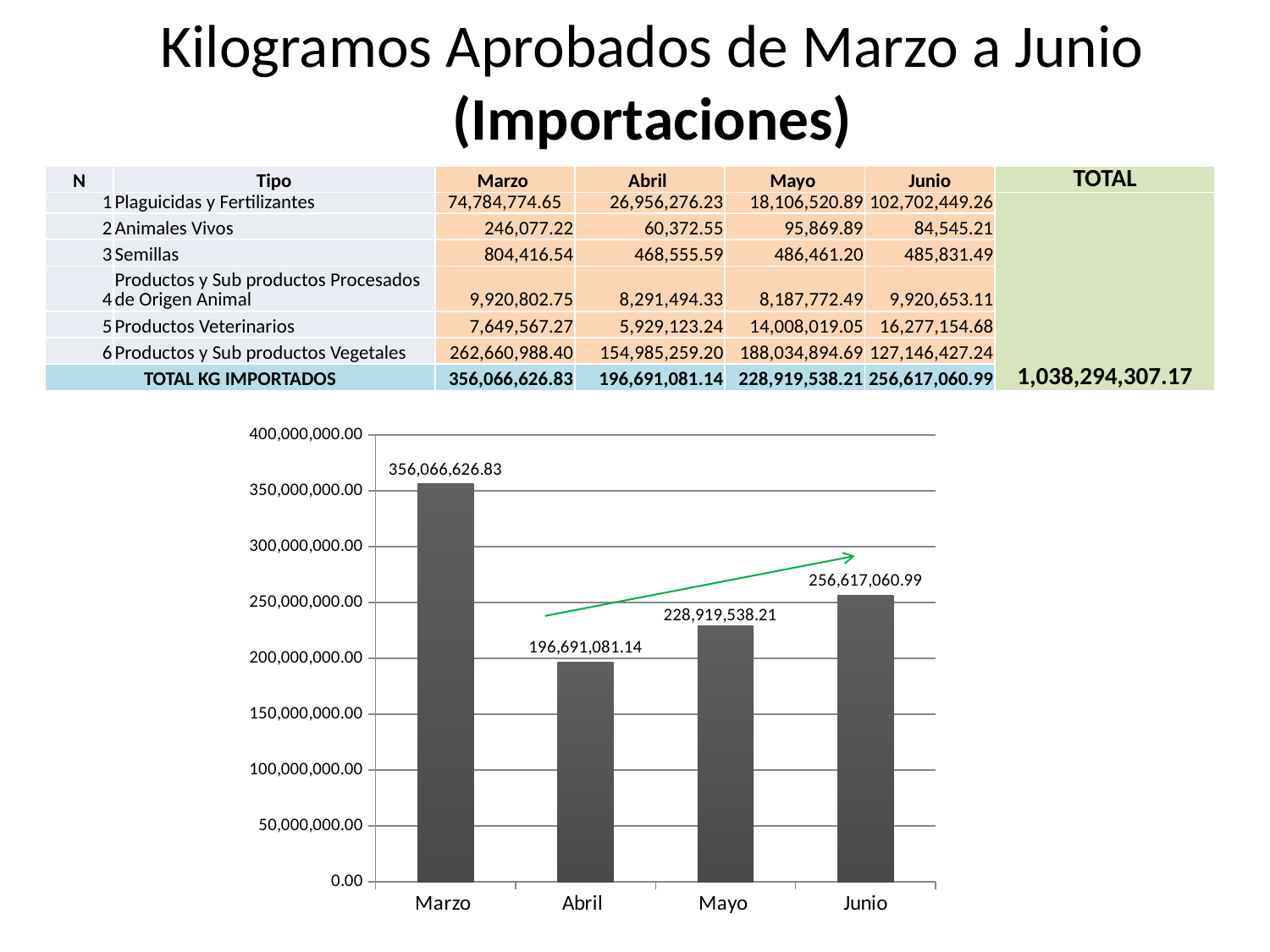
Which is larger in the chart, the value for Mayo or the value for Junio? Junio What kind of chart is shown on the slide? bar chart Which month has the lowest bar in the chart? Abril What is the value for Abril in the bar chart? 196,691,081.14 Is the value for Abril in the chart greater or less than 200,000,000.00? less Which month has the highest bar in the chart? Marzo What is the difference between the values for Junio and Mayo in the chart? 27,697,522.78 What is the value for Mayo in the bar chart? 228,919,538.21 What is the value for Junio in the bar chart? 256,617,060.99 What is the difference between the values for Marzo and Abril in the chart? 159,375,545.69 What is the value for Marzo in the bar chart? 356,066,626.83 How many months are plotted in the bar chart? 4